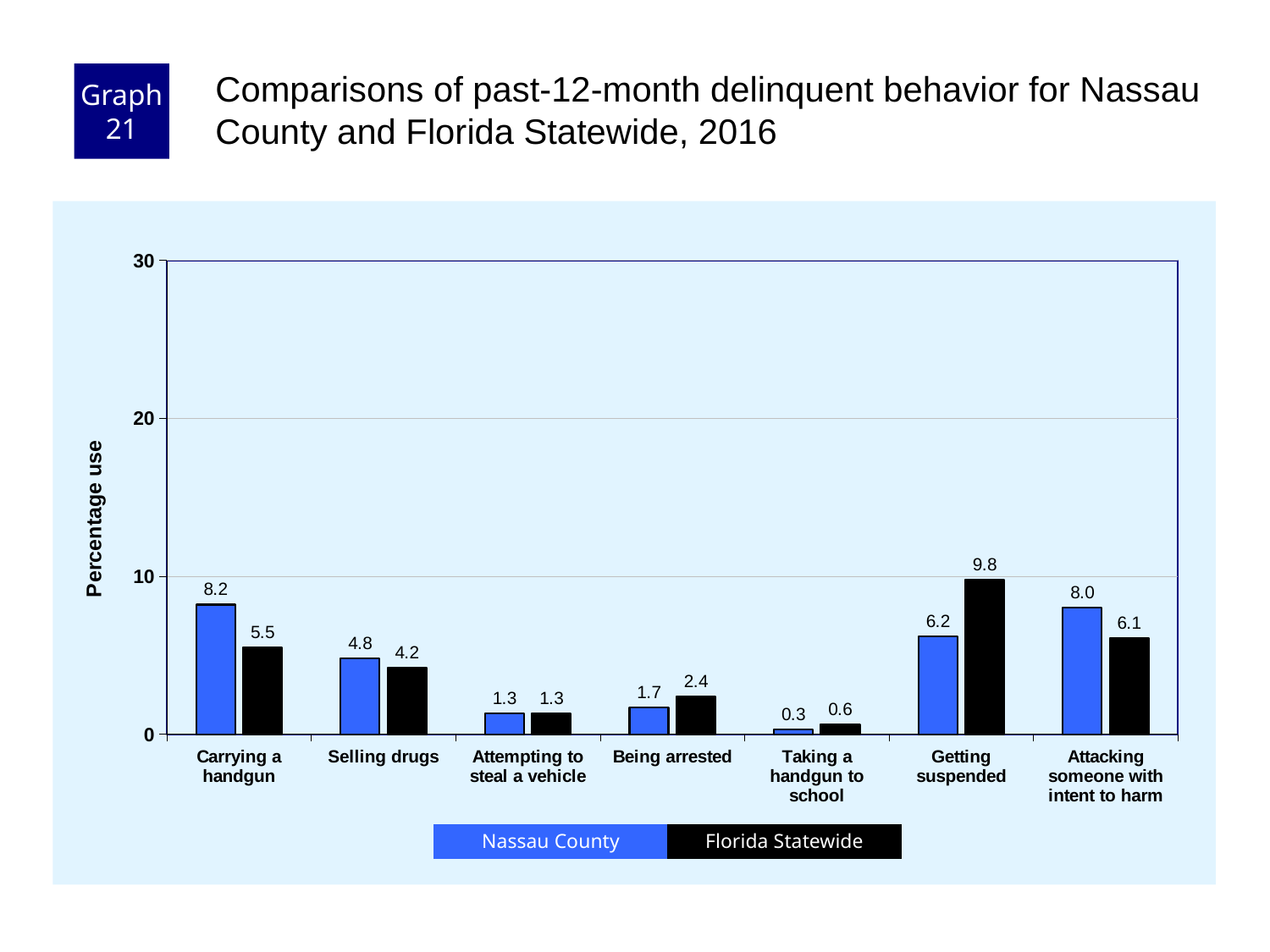
What is the difference between the Florida Statewide and Nassau County values for Getting suspended? 3.6 What is the Florida Statewide value for Getting suspended? 9.8 Which category has the lowest Nassau County value? Taking a handgun to school What is the Nassau County value for Carrying a handgun? 8.2 What is the Nassau County value for Taking a handgun to school? 0.3 Is the Florida Statewide value for Getting suspended greater or less than 10? less How many categories are shown on the x axis? 7 Which category has the highest Florida Statewide value? Getting suspended What kind of chart is shown on the slide? bar chart How many series does the legend list? 2 For Being arrested, which is larger: the Nassau County value or the Florida Statewide value? Florida Statewide What is the difference between the Nassau County and Florida Statewide values for Carrying a handgun? 2.7